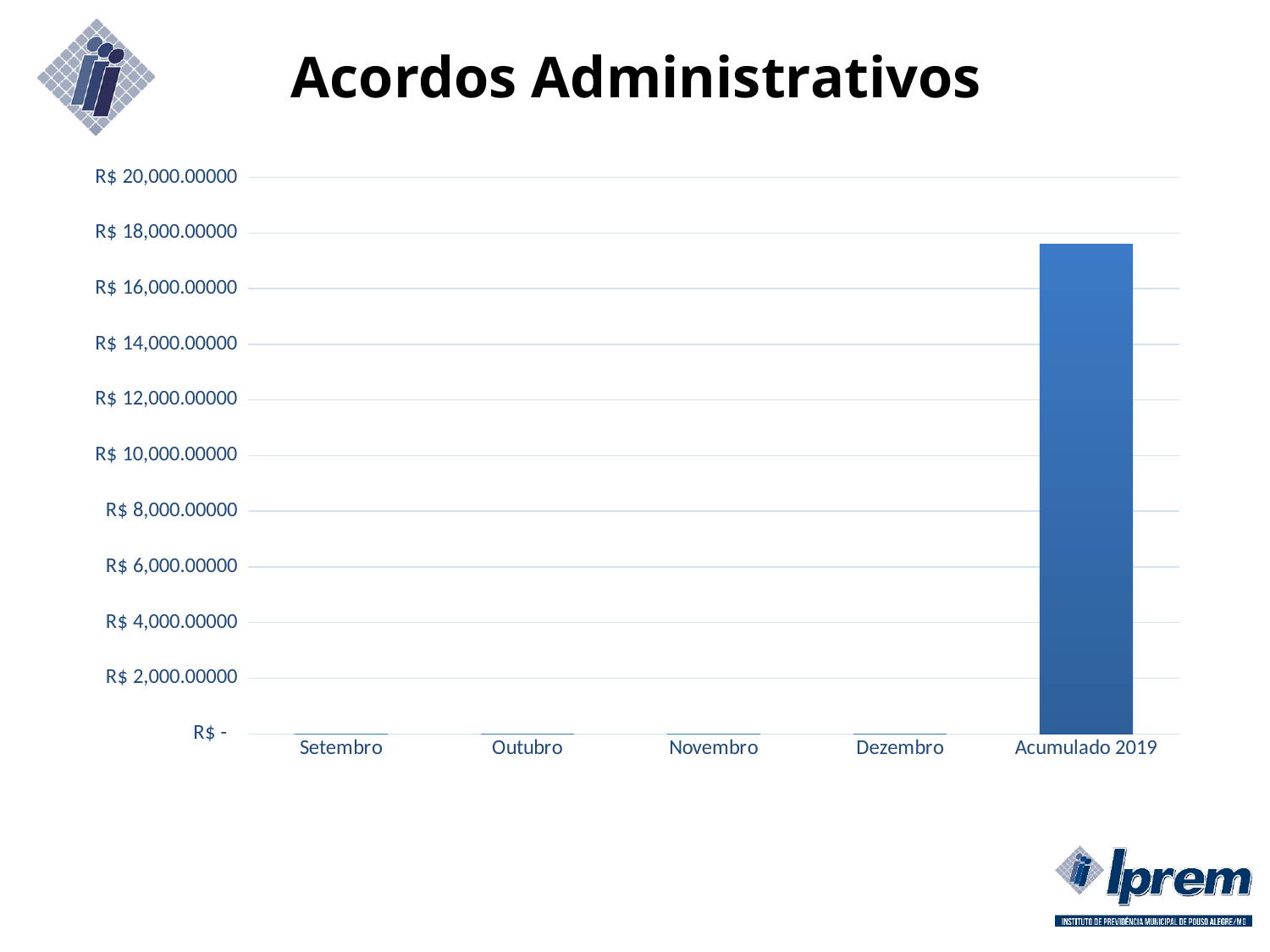
Is the value for Dezembro greater or less than R$ 2,000.00000? less What is the highest value shown on the y axis? R$ 20,000.00000 Which category has the highest value? Acumulado 2019 Which is larger, the value for Outubro or the value for Acumulado 2019? Acumulado 2019 Is the value for Acumulado 2019 greater or less than R$ 16,000.00000? greater What kind of chart is shown on the slide? bar chart How many categories are shown on the x axis? 5 Is the value for Acumulado 2019 greater or less than R$ 18,000.00000? less What is the title of the chart? Acordos Administrativos What is the label of the last category on the x axis? Acumulado 2019 Which is larger, the value for Acumulado 2019 or the value for Novembro? Acumulado 2019